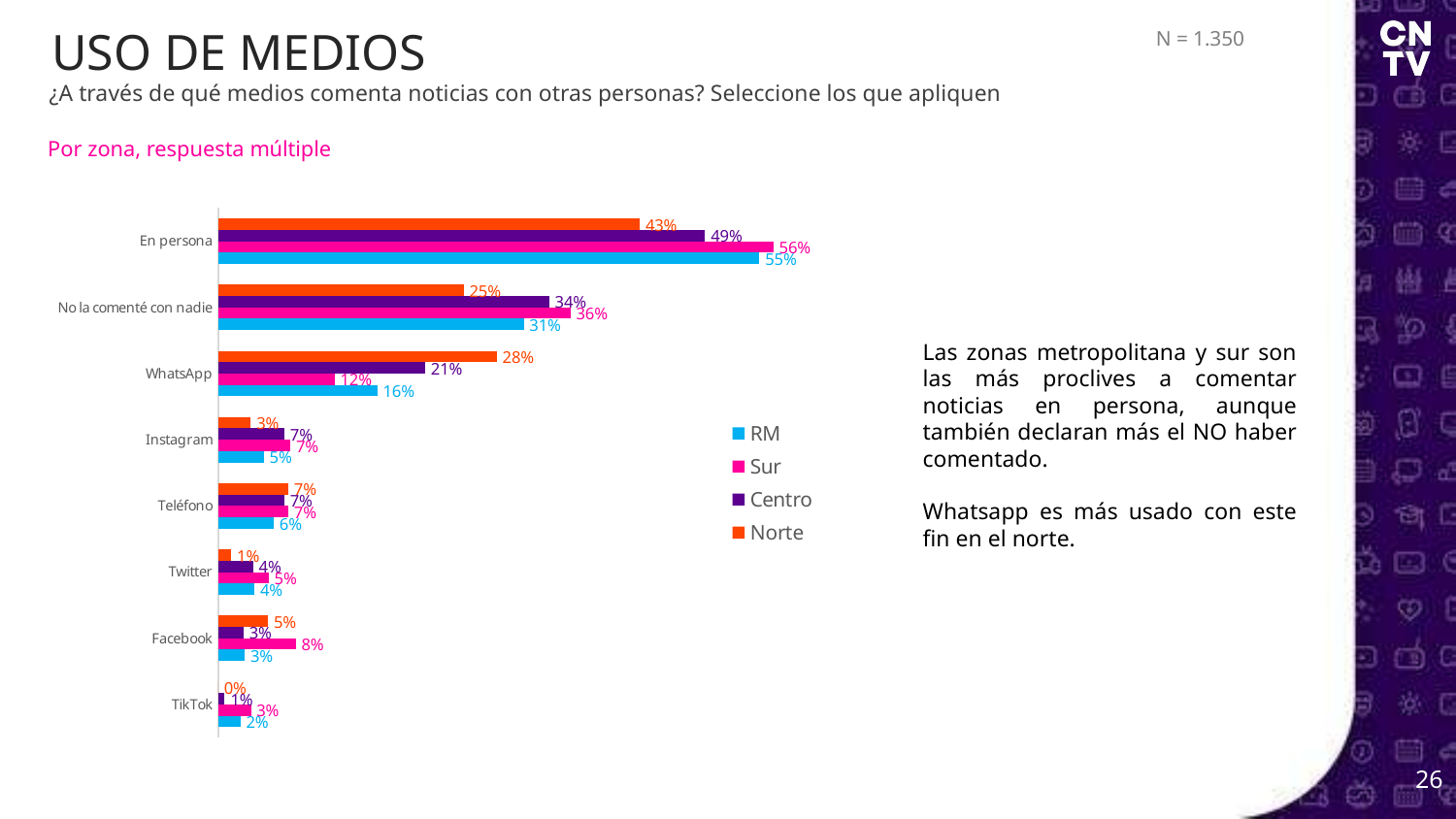
What is the difference between the Sur and Norte values for 'En persona'? 13% How many categories (media) are shown on the chart? 8 What kind of chart is shown on the slide? Bar chart What is the value for Sur in the 'En persona' category? 56% What is the value for RM in the 'No la comenté con nadie' category? 31% Which zone has the highest value for 'WhatsApp'? Norte What is the value for Norte in the 'TikTok' category? 0% What is the value for Norte in the 'WhatsApp' category? 28% Which series is shown in orange in the legend? Norte Which is larger for 'Facebook': the value for Sur or the value for Centro? Sur Which zone has the lowest value for 'En persona'? Norte How many series does the legend list? 4